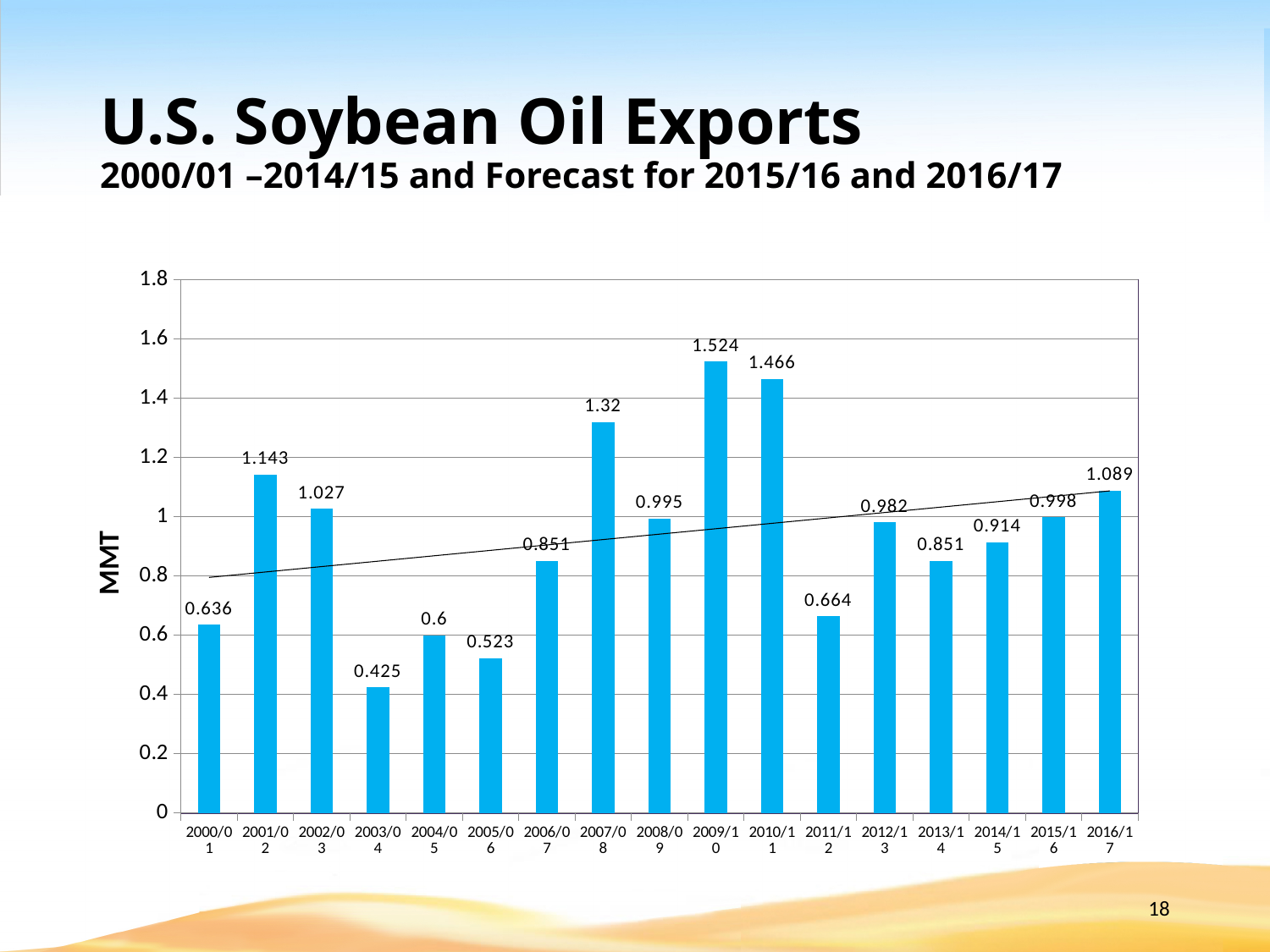
Which year has the highest value? 2009/10 Which is larger, the value for 2007/08 or the value for 2001/02? 2007/08 Is the value for 2011/12 greater or less than 0.8? less Does the trend line drawn across the chart rise or fall from left to right? rise What is the value for 2009/10? 1.524 What is the value for 2003/04? 0.425 What is the forecast value for 2016/17? 1.089 What kind of chart is this? bar chart What is the label on the y axis? MMT How many years are shown on the x axis? 17 Which year has the lowest value? 2003/04 What is the difference between the values for 2009/10 and 2010/11? 0.058